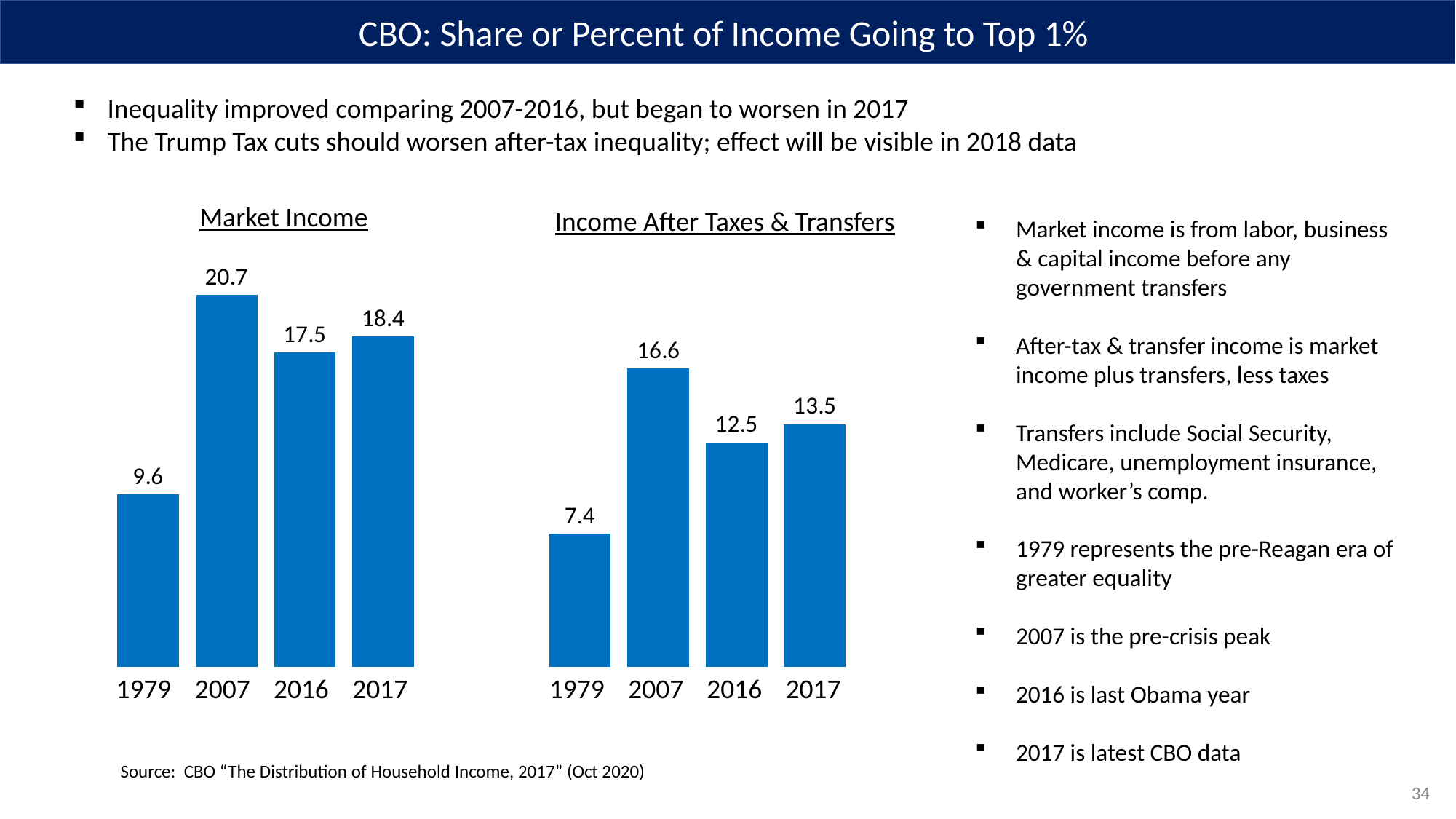
What is the title of the chart on the left? Market Income In the Income After Taxes & Transfers chart, which year has the highest value? 2007 What type of chart is the Market Income chart? bar chart In the Income After Taxes & Transfers chart, what is the difference between the 2017 and 2016 values? 1.0 In the Income After Taxes & Transfers chart, what is the value for 1979? 7.4 In the Market Income chart, which is larger, the value for 2016 or the value for 2017? 2017 In the Market Income chart, what is the value for 2007? 20.7 In the Market Income chart, what is the value for 2017? 18.4 In the Market Income chart, what is the difference between the 2007 and 2016 values? 3.2 In the Income After Taxes & Transfers chart, do the values rise or fall from 2007 to 2016? fall In the Market Income chart, which year has the lowest value? 1979 How many bars are in the Income After Taxes & Transfers chart? 4